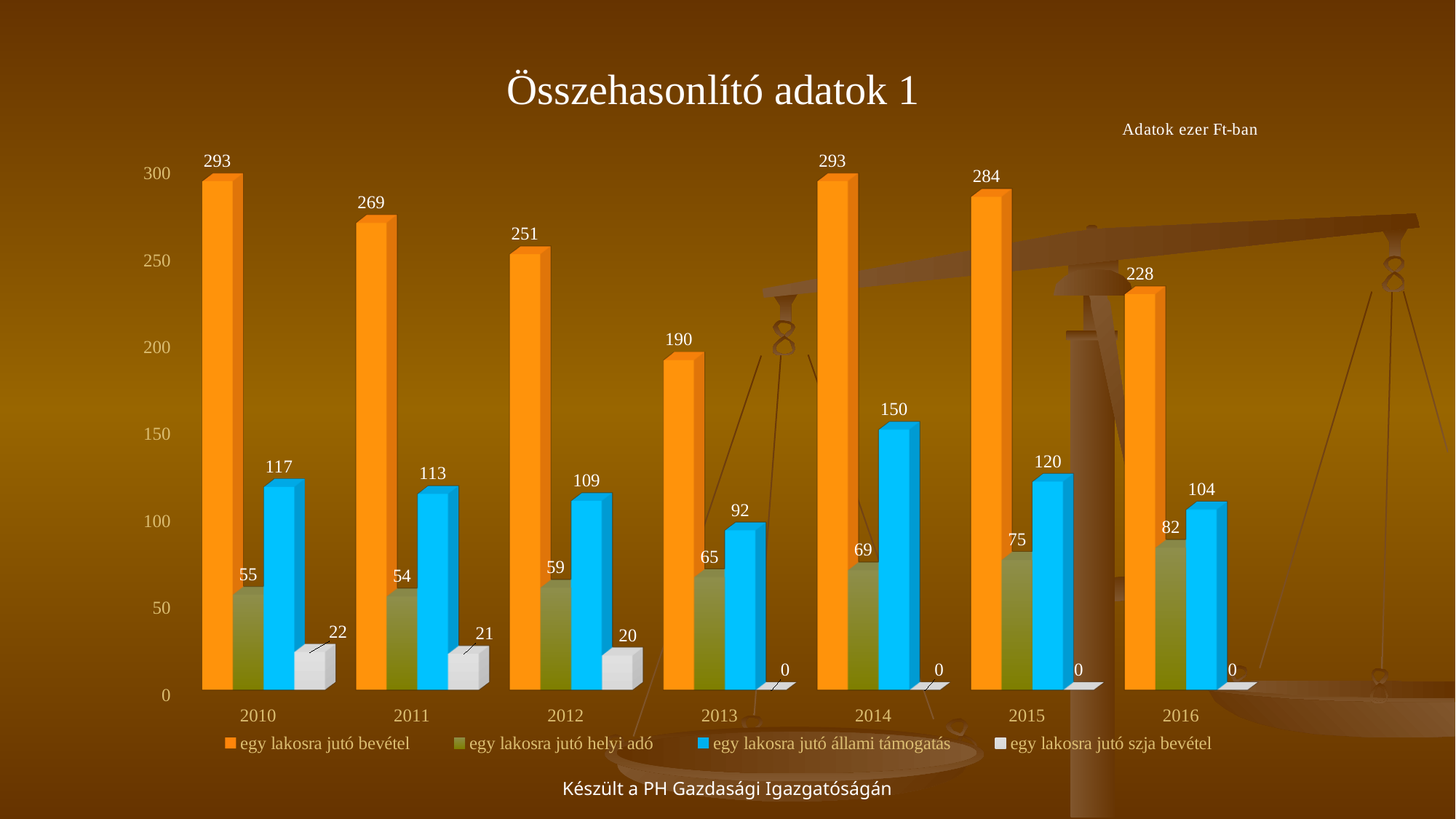
What is the title of the chart? Adatok ezer Ft-ban What is the difference between 'egy lakosra jutó bevétel' in 2015 and in 2016? 56 How many years are shown on the x axis? 7 What is the value of 'egy lakosra jutó bevétel' in 2012? 251 In which year is 'egy lakosra jutó bevétel' the lowest? 2013 In which year is 'egy lakosra jutó helyi adó' the highest? 2016 What is the value of 'egy lakosra jutó szja bevétel' in 2011? 21 Does 'egy lakosra jutó helyi adó' rise or fall from 2011 to 2016? rise How many series does the legend list? 4 What type of chart is shown on the slide? bar chart What is the value of 'egy lakosra jutó állami támogatás' in 2014? 150 Which is larger in 2013: 'egy lakosra jutó helyi adó' or 'egy lakosra jutó állami támogatás'? egy lakosra jutó állami támogatás